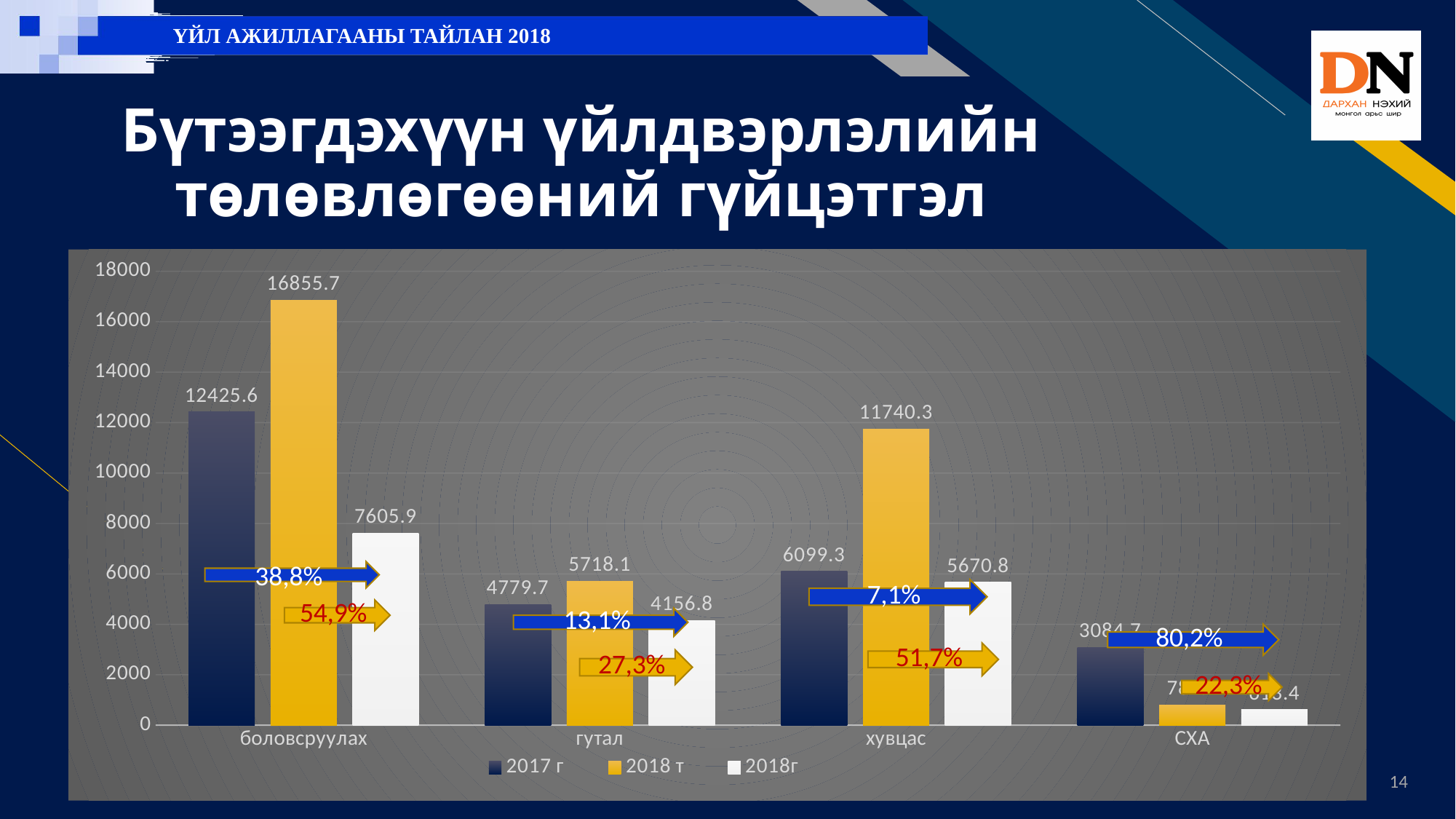
What is the difference between the 2018 т and 2017 г values for боловсруулах? 4430.1 Which legend entry is shown in yellow? 2018 т What is the value of the 2017 г series for хувцас? 6099.3 How many series does the chart legend list? 3 What type of chart is shown on the slide? bar chart Which category has the highest 2018 т value? боловсруулах How many categories are shown on the x axis of the chart? 4 What is the value of the 2018 т series for боловсруулах? 16855.7 Which category has the lowest 2017 г value? СХА Which is larger for хувцас: the 2017 г value or the 2018г value? 2017 г What is the value of the 2018г series for гутал? 4156.8 Is the 2018 т value for хувцас greater or less than 10000? greater